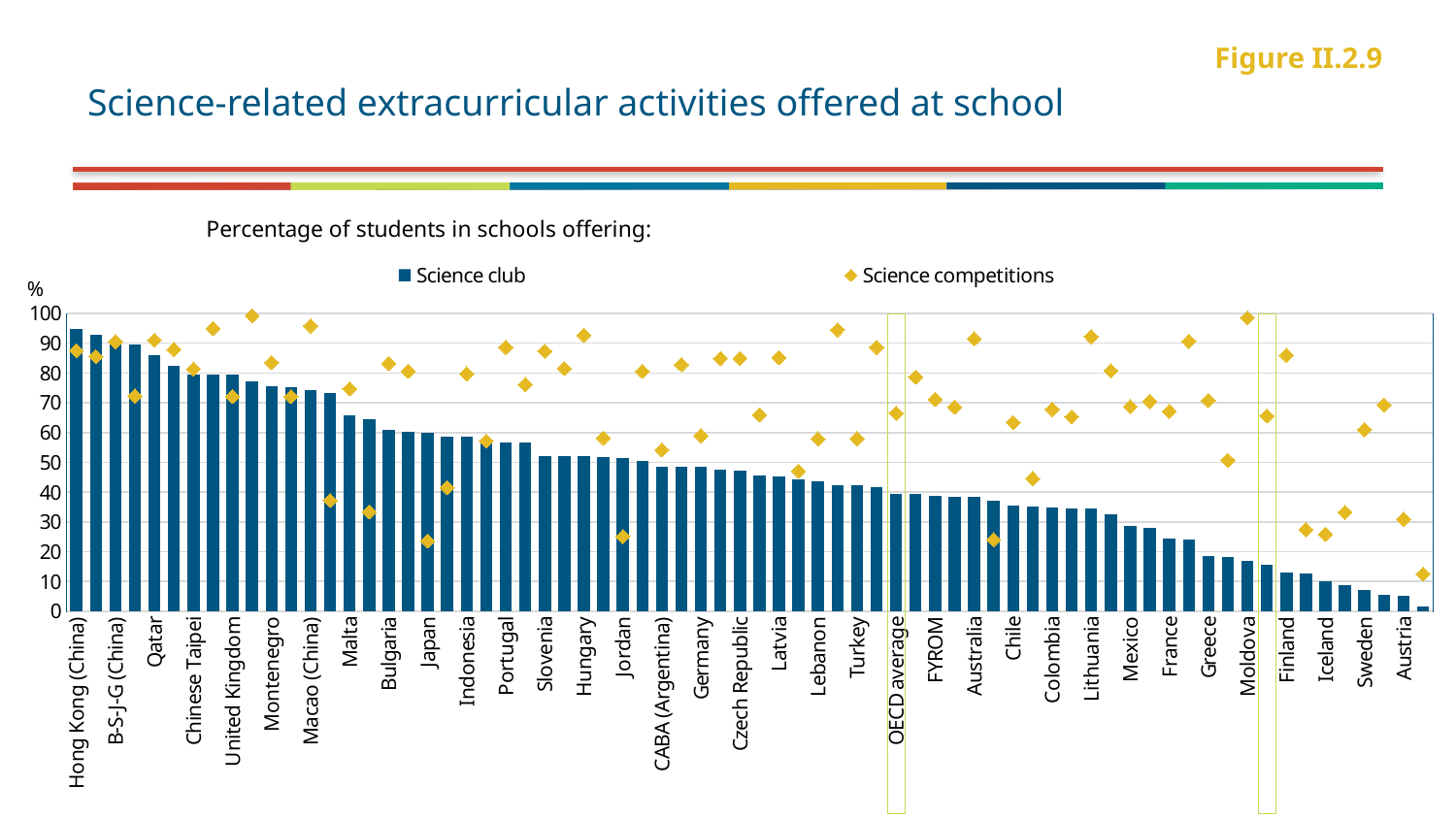
Which has the larger Science club value, Hong Kong (China) or Austria? Hong Kong (China) What is the figure number shown on the slide? Figure II.2.9 What kind of chart is shown on the slide? bar chart Do the Science club bars rise or fall from left to right along the x axis? fall Which series is shown with bars and which with diamond markers? Science club is bars; Science competitions is diamonds Is the Science club value for Finland greater or less than 20? less Which labelled country has the highest Science club value? Hong Kong (China) Is the Science competitions value for Japan greater or less than 30? less How many series does the legend list? 2 Is the Science competitions value for Moldova greater or less than 90? greater For Japan, which is larger: the Science club value or the Science competitions value? Science club